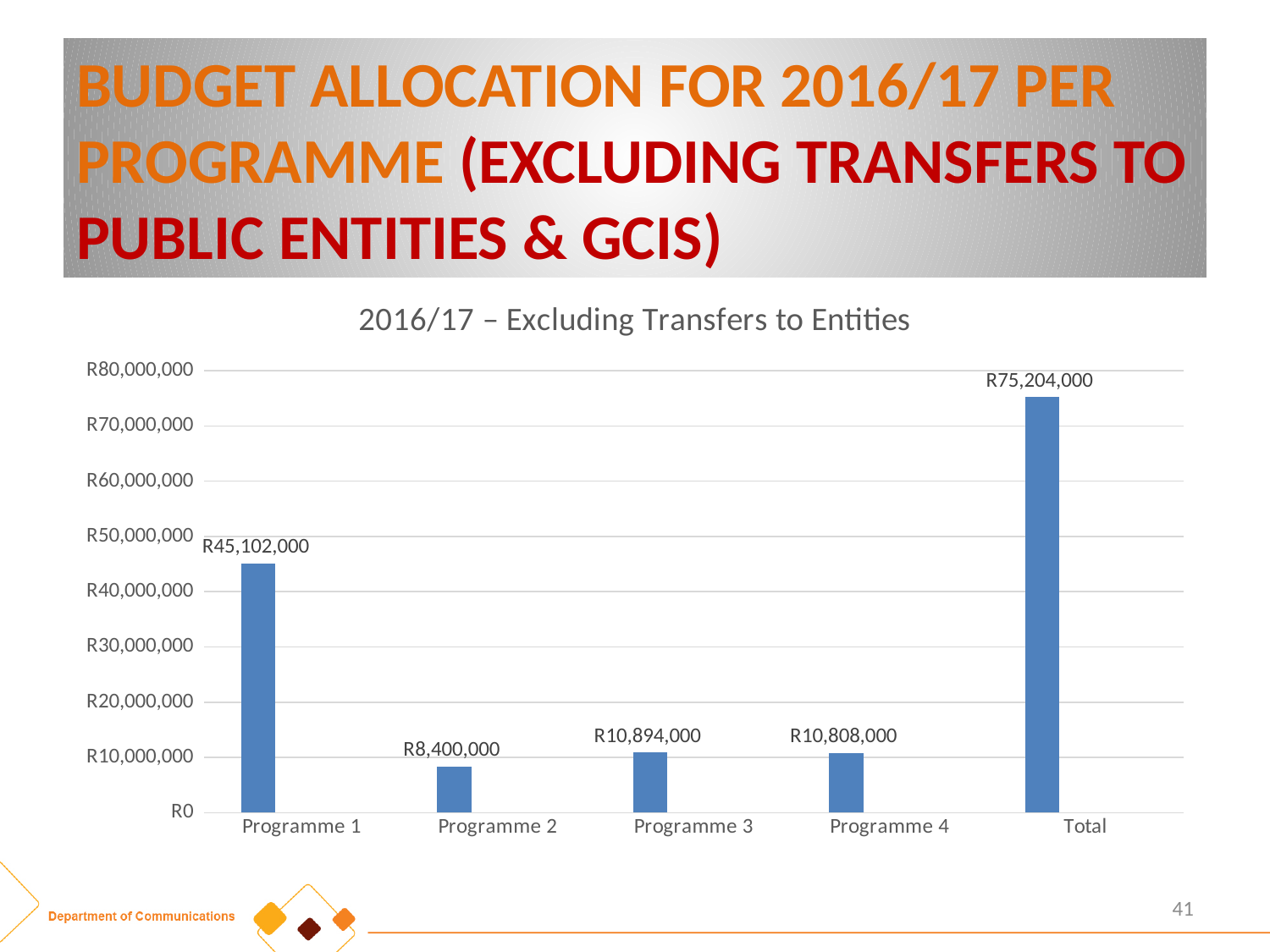
What is the title of the chart? 2016/17 – Excluding Transfers to Entities What is the value shown for Programme 3? R10,894,000 What kind of chart is shown on the slide? Bar chart What is the value shown for Programme 1? R45,102,000 How many bars are plotted in the chart? 5 What is the value shown for the Total bar? R75,204,000 What is the value shown for Programme 2? R8,400,000 Is the value for Programme 1 greater or less than R40,000,000? greater Which is larger, the value for Programme 1 or the value for Programme 4? Programme 1 Which category has the tallest bar in the chart? Total Which category has the lowest value in the chart? Programme 2 What is the difference between the values for Programme 1 and Programme 2? R36,702,000